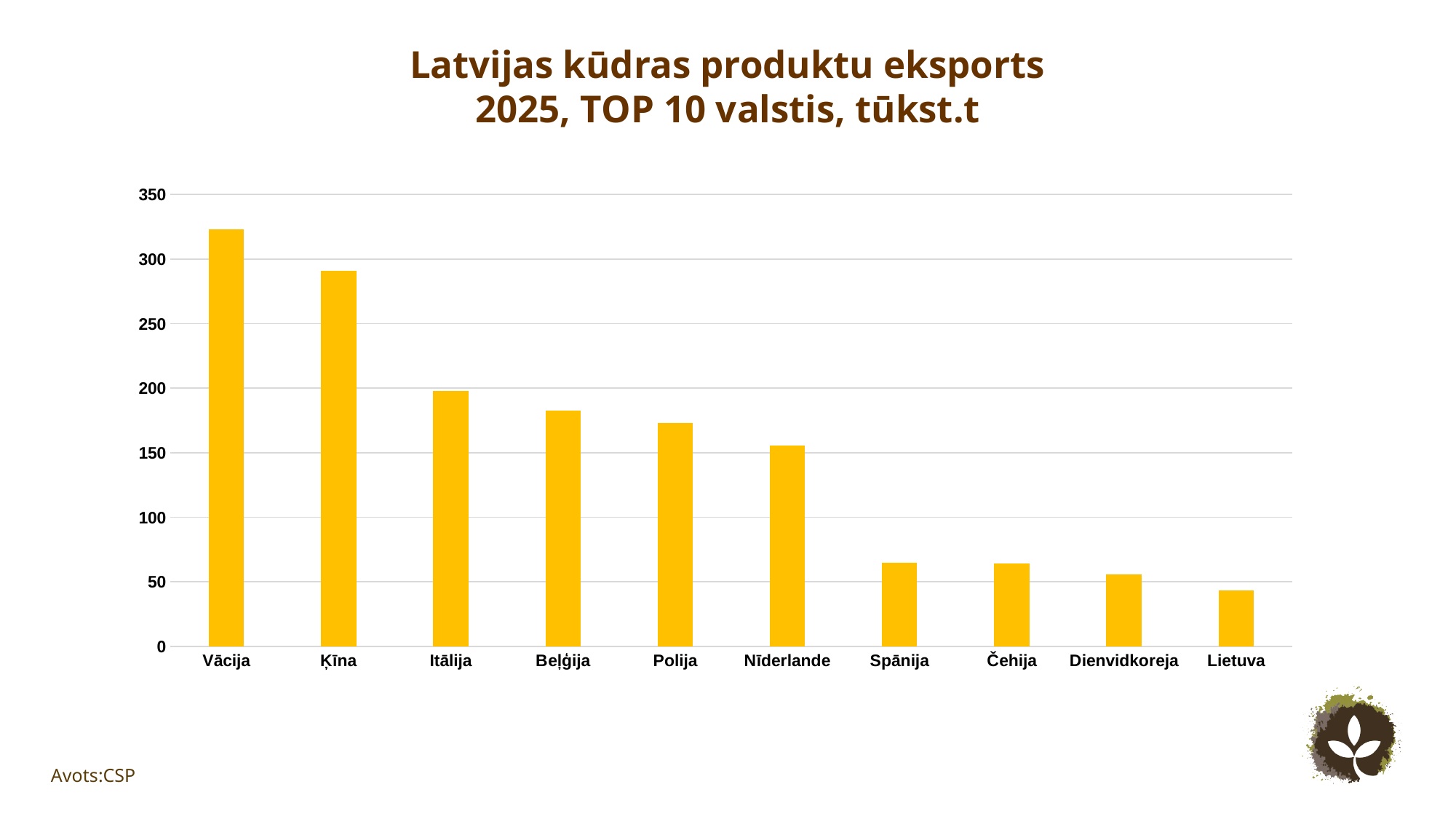
Is the value for Nīderlande greater or less than 150? greater Is the value for Lietuva greater or less than 50? less Is the value for Vācija greater or less than 300? greater Which is larger, the value for Beļģija or the value for Polija? Beļģija How many countries are shown in the chart? 10 Do the values rise or fall from left to right along the x axis? fall What is the title of the chart? Latvijas kūdras produktu eksports 2025, TOP 10 valstis, tūkst.t Which country has the lowest value in the chart? Lietuva What type of chart is shown on the slide? bar chart Which country has the highest value in the chart? Vācija